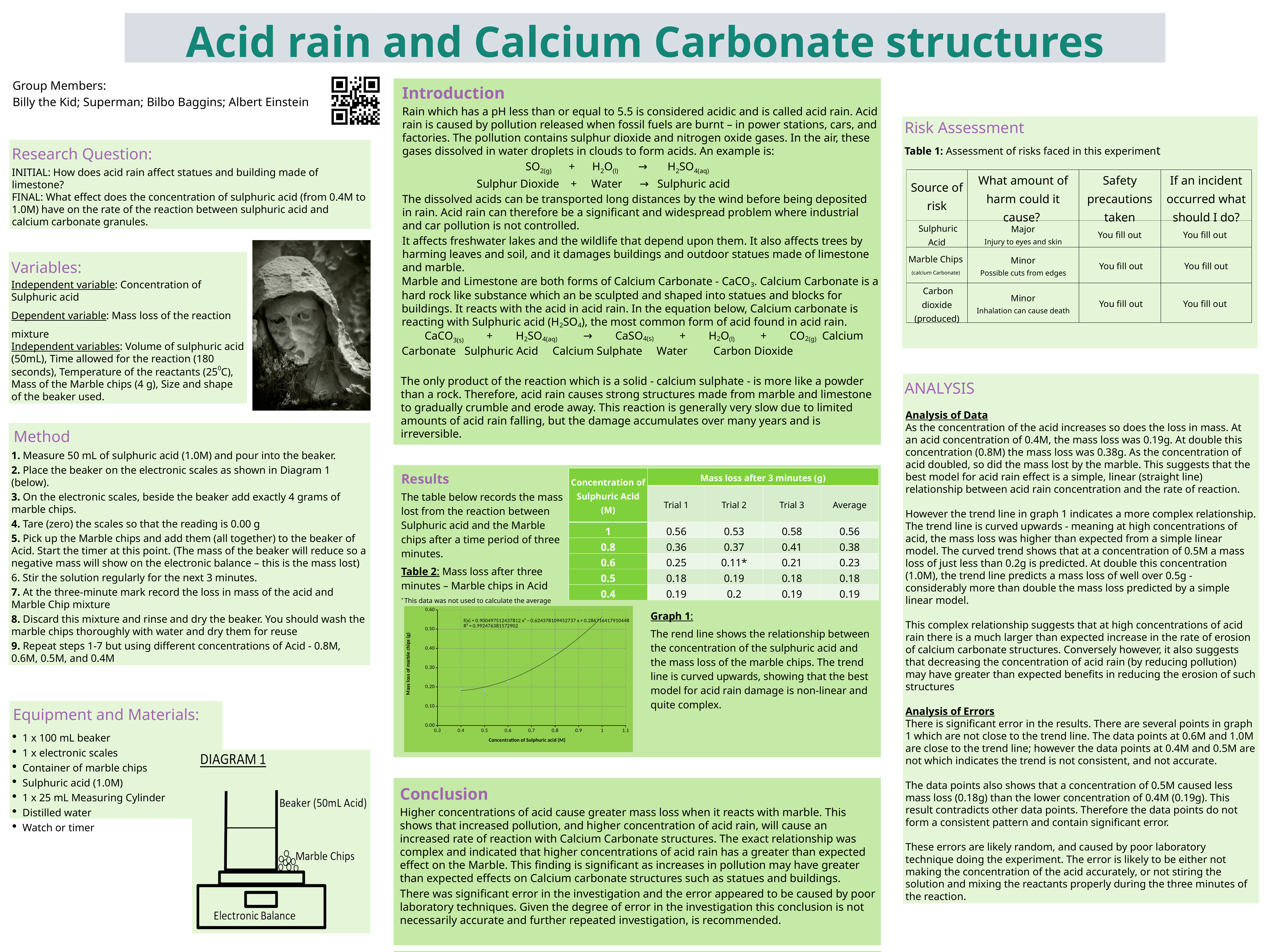
In Graph 1, which has the larger mass loss: a concentration of 1 M or 0.8 M? 1 M In Graph 1, does the mass loss rise or fall as the concentration of sulphuric acid increases along the x axis? Rises In Graph 1, is the mass loss at a concentration of 0.8 M greater or less than 0.30 g? greater In Graph 1, which concentration of sulphuric acid has the highest mass loss? 1 What is the title of the x axis in Graph 1? Concentration of Sulphuric acid (M) What kind of chart is Graph 1? Scatter chart with a trend line In Graph 1, which has the larger mass loss: a concentration of 0.8 M or 0.6 M? 0.8 M In Graph 1, how many data points are plotted? 5 In Graph 1, is the mass loss at a concentration of 0.4 M greater or less than 0.30 g? less What is the title of the y axis in Graph 1? Mass loss of marble chips (g) In Graph 1, is the mass loss at a concentration of 0.6 M greater or less than 0.30 g? less